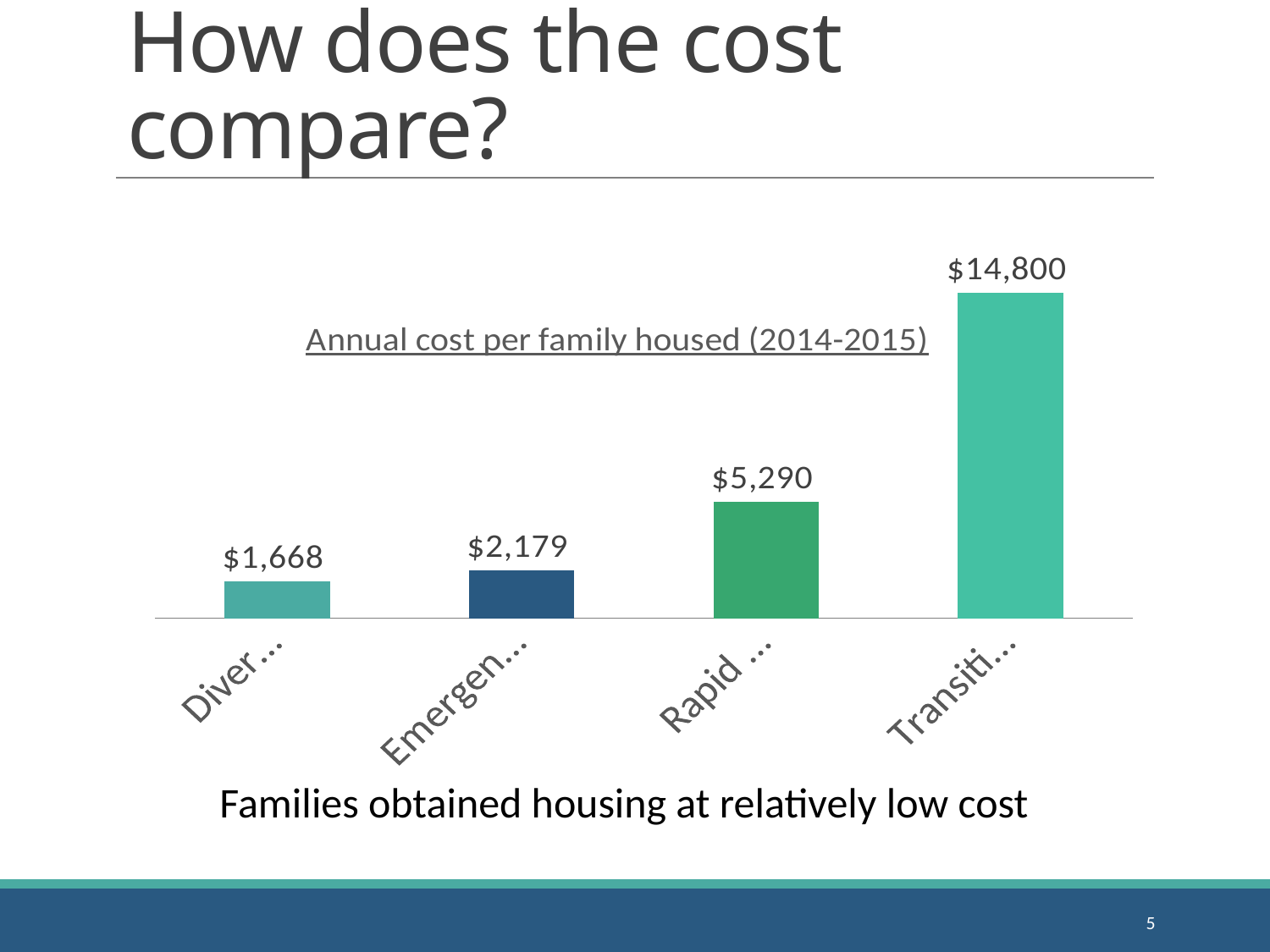
What is the value of the second bar from the left (labelled "Emergen…")? $2,179 What kind of chart is shown on the slide? bar chart What is the value of the first bar from the left (labelled "Diver…")? $1,668 Which is larger: the value of the third bar (Rapid …) or the second bar (Emergen…)? the third bar (Rapid …) Which bar has the lowest annual cost per family housed? the leftmost bar (Diver…) What is the value of the rightmost bar (labelled "Transiti…")? $14,800 What is the title of the chart? Annual cost per family housed (2014-2015) What is the value of the third bar from the left (labelled "Rapid …")? $5,290 Do the bar values rise or fall from left to right across the chart? rise What is the difference between the rightmost bar ($14,800) and the leftmost bar ($1,668)? $13,132 How many bars does the chart show? 4 Which bar has the highest annual cost per family housed? the rightmost bar (Transiti…)